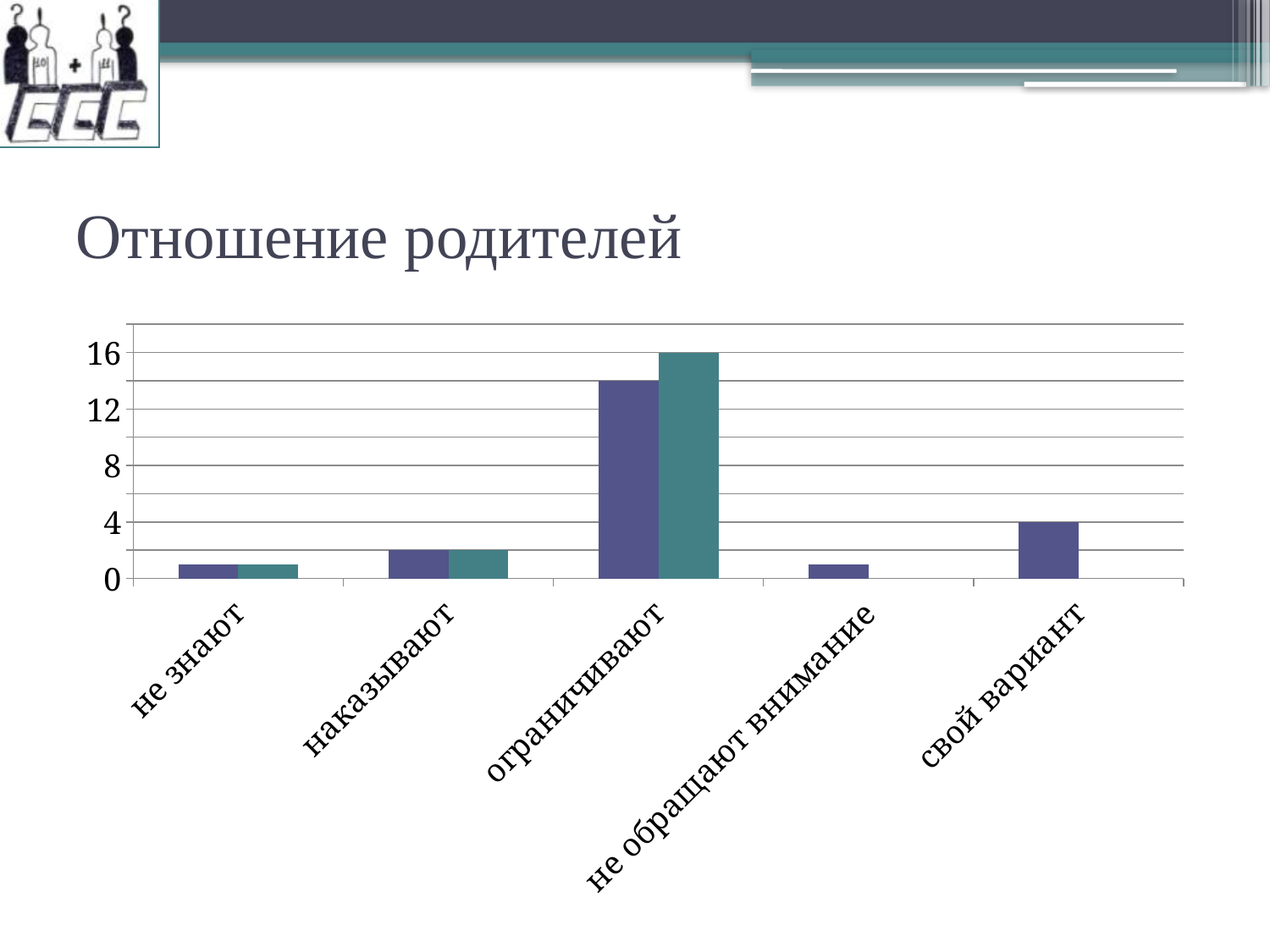
What is the title of the chart? Отношение родителей What is the value of the purple bar for свой вариант? 4 What is the value of the teal bar for ограничивают? 16 What two colours are used for the bars in the chart? purple and teal Is the value of the purple bar for наказывают greater or less than 4? less Is the value of the teal bar for не знают greater or less than 4? less For ограничивают, which bar is taller, the purple one or the teal one? the teal one Which purple bar is taller, свой вариант or наказывают? свой вариант How many categories are shown on the x axis of the chart? 5 Is the value of the purple bar for ограничивают greater or less than 12? greater Which category has the tallest bars in the chart? ограничивают What kind of chart is shown on the slide? bar chart